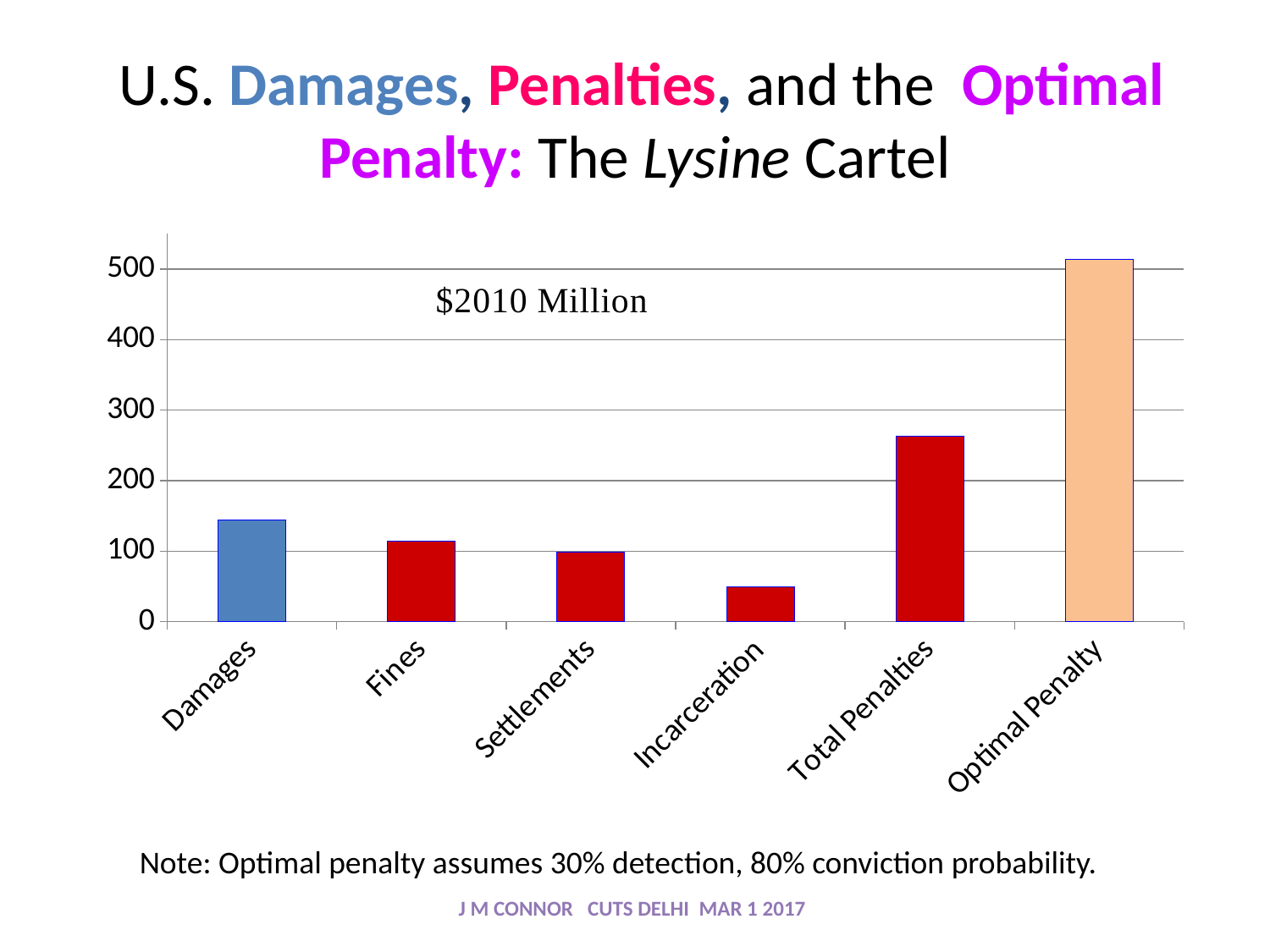
Which category has the lowest value? Incarceration What unit is stated inside the chart area? $2010 Million Is the value for Incarceration greater or less than 100? less Is the value for Optimal Penalty greater or less than 400? greater Which is larger, the value for Total Penalties or the value for Damages? Total Penalties Is the value for Total Penalties greater or less than 300? less How many categories are plotted on the x axis? 6 Which is larger, the value for Damages or the value for Fines? Damages Which category has the highest value? Optimal Penalty What kind of chart is shown on the slide? bar chart